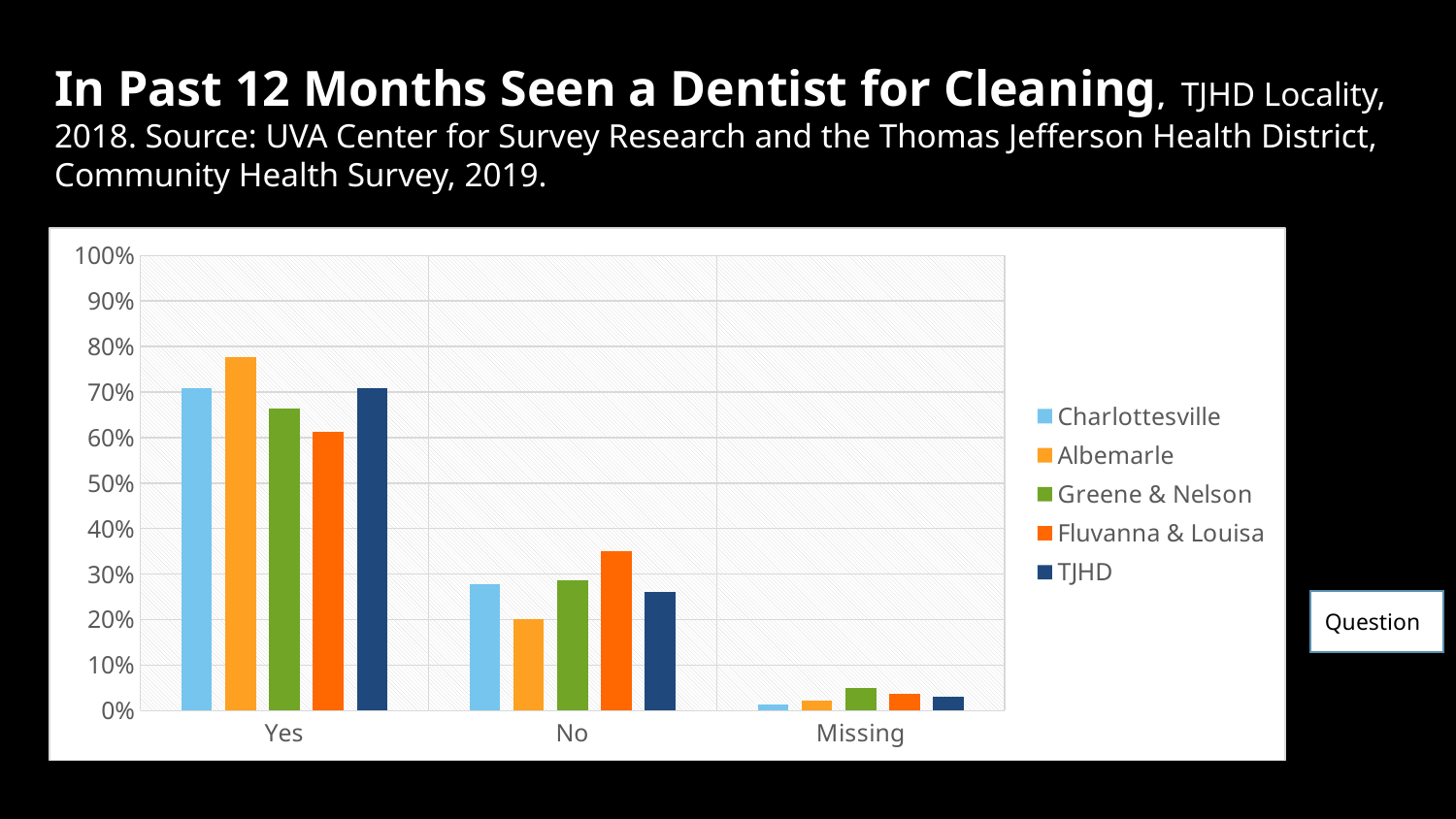
Is the value for Albemarle in the No category greater or less than 30%? less Which locality has the highest value for the No category? Fluvanna & Louisa Is the value for Fluvanna & Louisa in the No category greater or less than 30%? greater What kind of chart is shown on the slide? bar chart Which locality has the lowest value for the No category? Albemarle Which locality has the highest value for the Yes category? Albemarle Which is larger: the Yes value for Albemarle or the Yes value for Greene & Nelson? Albemarle How many categories are shown on the x axis? 3 Which locality has the lowest value for the Yes category? Fluvanna & Louisa Is the value for Albemarle in the Yes category greater or less than 70%? greater How many series does the legend list? 5 Which legend entry is shown in dark blue? TJHD